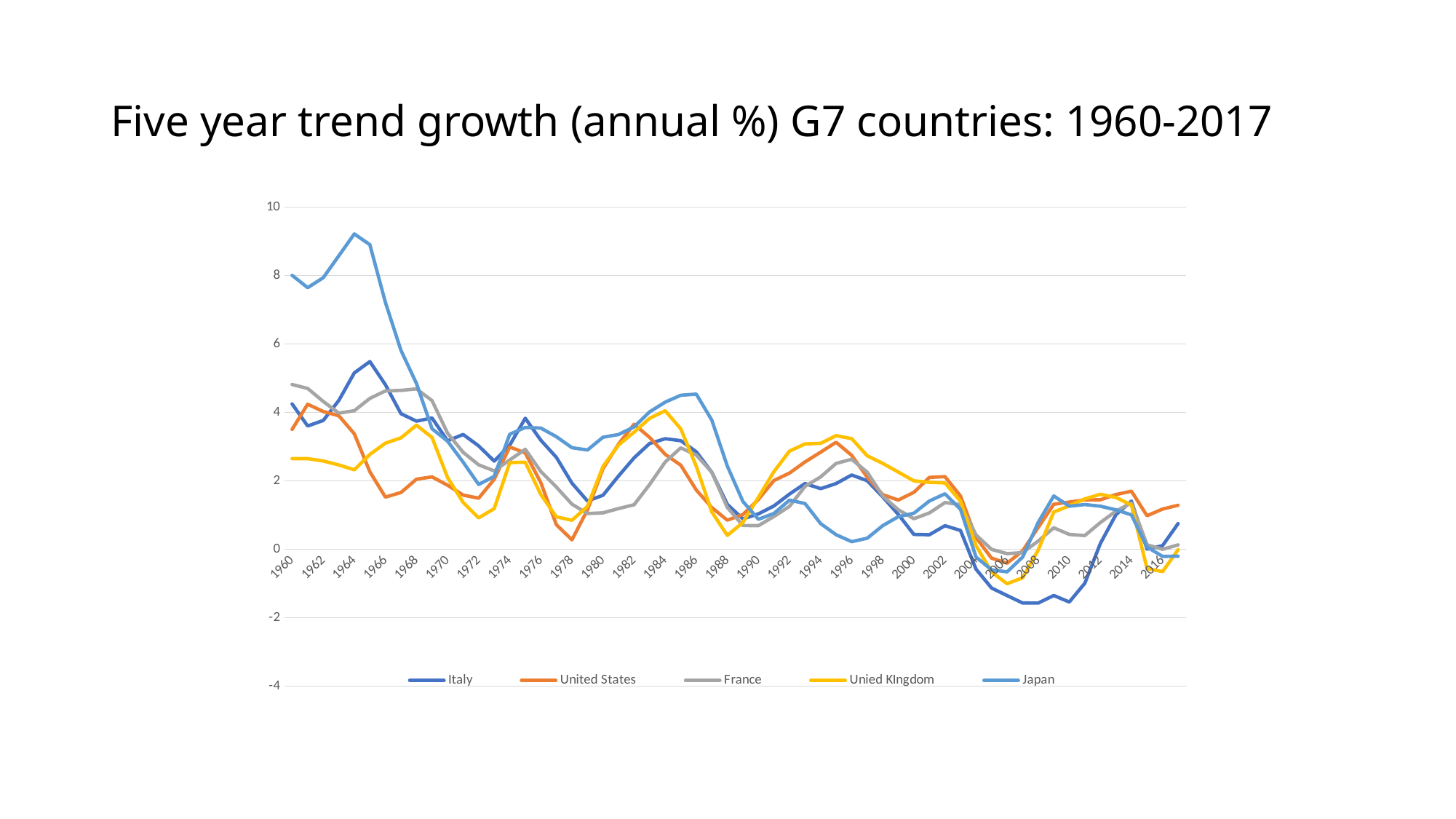
Which series has the highest value in 1986? Japan Is the value for Japan in 1964 greater or less than 8? greater Which is higher in 1960, Japan or Italy? Japan Does the Japan line generally rise or fall from 1960 to 2016? fall Is the value for the United States in 1978 greater or less than 2? less Which series reaches the lowest value anywhere on the chart? Italy What is the title of the chart? Five year trend growth (annual %) G7 countries: 1960-2017 What kind of chart is shown on the slide? Line chart How many series does the legend list? 5 Is the value for France in 1960 greater or less than 4? greater Which series reaches the highest value anywhere on the chart? Japan